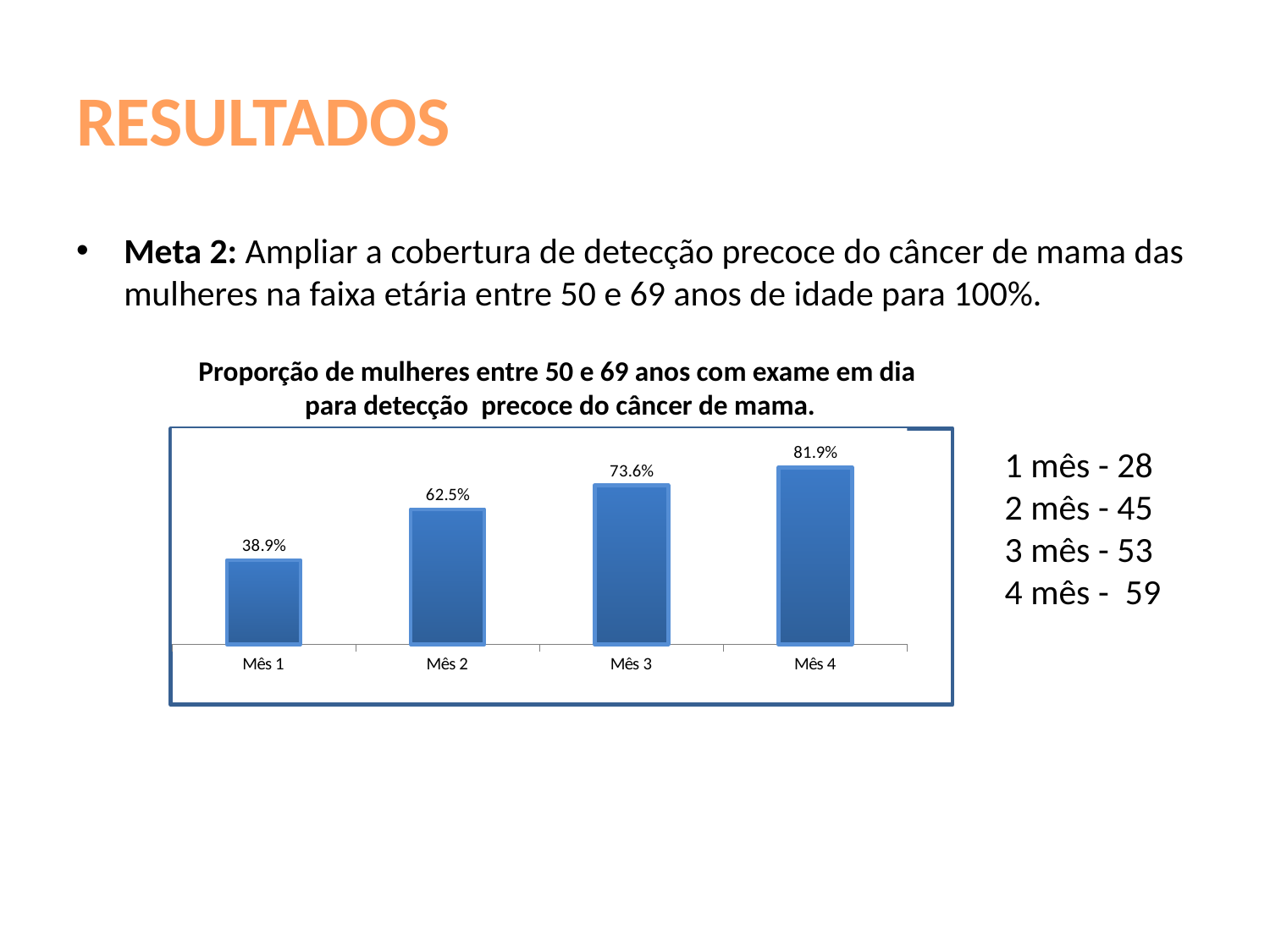
What is the value for Mês 1? 38.9% Which is larger, the value for Mês 2 or the value for Mês 3? Mês 3 Which month has the highest value? Mês 4 What is the value for Mês 3? 73.6% What is the value for Mês 2? 62.5% What is the value for Mês 4? 81.9% Which month has the lowest value? Mês 1 What is the difference between the values for Mês 2 and Mês 1? 23.6% What kind of chart is shown on the slide? Bar chart How many months are shown on the chart? 4 What is the difference between the values for Mês 4 and Mês 1? 43.0% Do the values rise or fall from Mês 1 to Mês 4? Rise